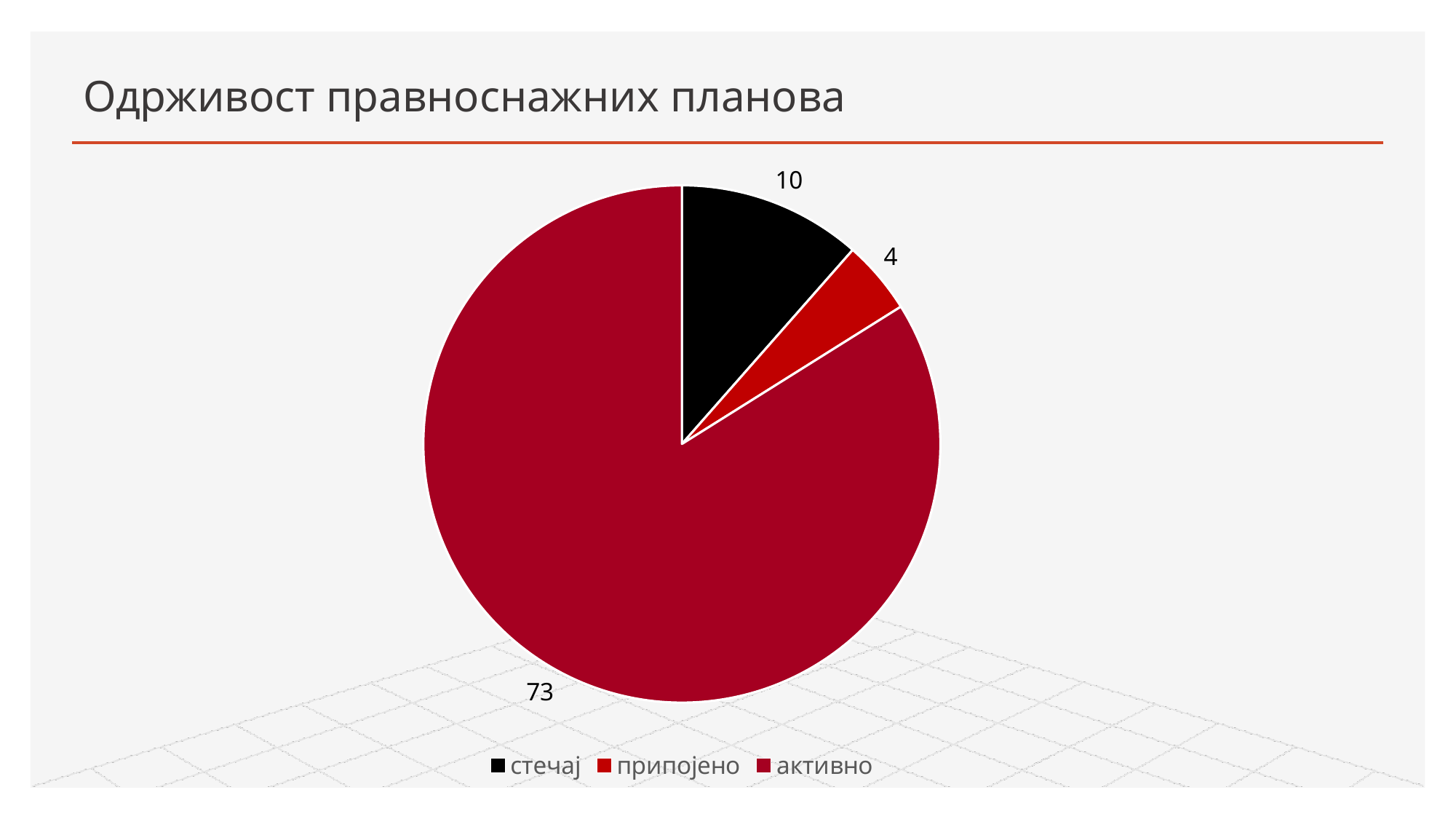
Which is larger, the value for стечај or the value for припојено? стечај What is the difference between the values for стечај and припојено? 6 Which category has the largest slice? активно What is the title of the chart slide? Одрживост правноснажних планова What is the difference between the values for активно and стечај? 63 Which category has the smallest slice? припојено How many slices does the pie chart have? 3 What is the total of all slices in the pie chart? 87 What is the value for стечај? 10 What is the value for активно? 73 What type of chart is shown on the slide? pie chart What is the value for припојено? 4